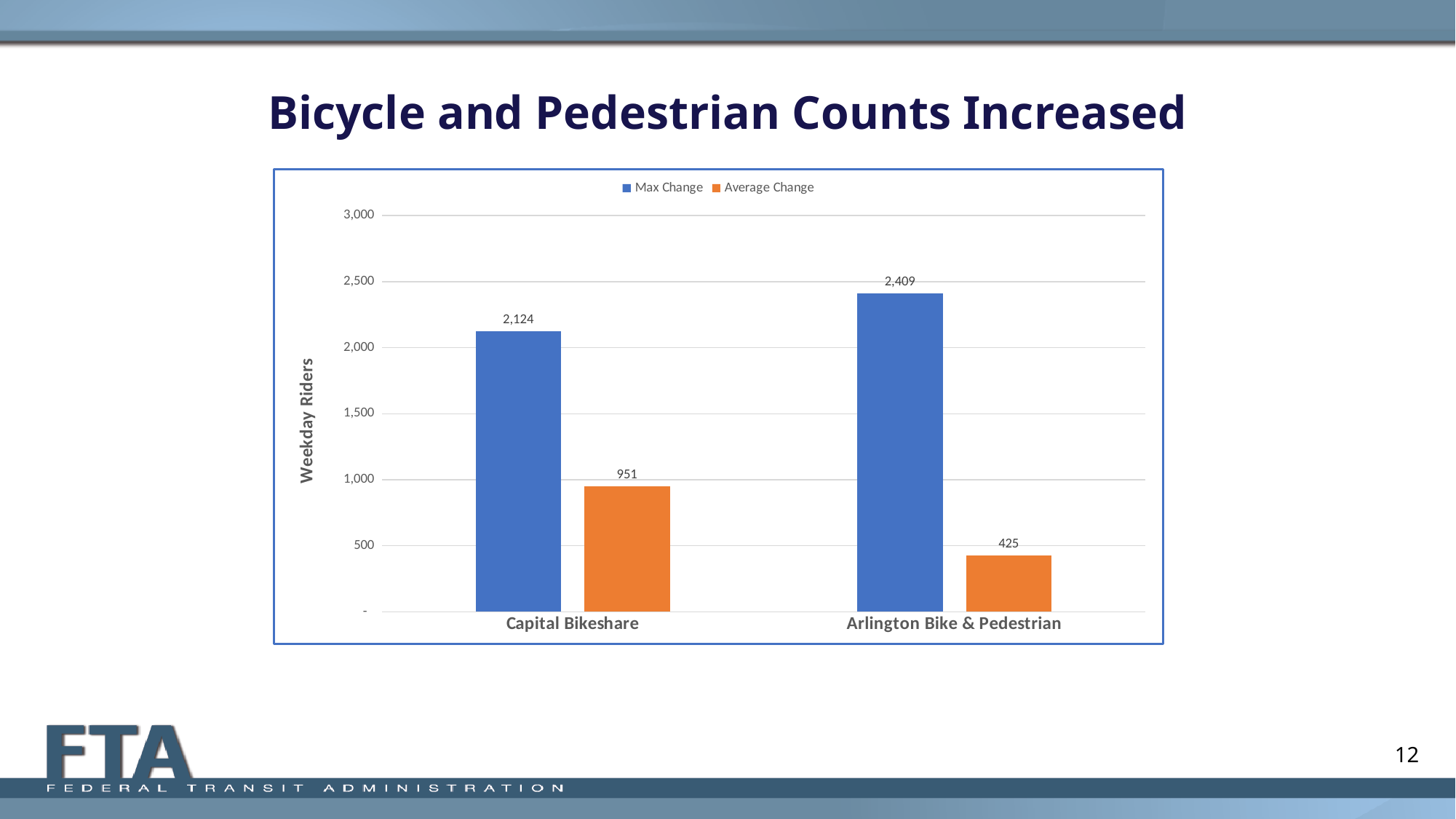
Which category has the lowest Average Change value? Arlington Bike & Pedestrian What is the difference between the Average Change values for Capital Bikeshare and Arlington Bike & Pedestrian? 526 How many series does the legend list? 2 What is the Average Change value for Arlington Bike & Pedestrian? 425 Is the Max Change value for Arlington Bike & Pedestrian greater or less than 2,500? less What kind of chart is shown on the slide? bar chart What is the Average Change value for Capital Bikeshare? 951 What is the difference between the Max Change values for Arlington Bike & Pedestrian and Capital Bikeshare? 285 Which is larger: the Average Change for Capital Bikeshare or the Average Change for Arlington Bike & Pedestrian? Capital Bikeshare What is the Max Change value for Capital Bikeshare? 2,124 Which category has the highest Max Change value? Arlington Bike & Pedestrian How many categories are shown on the x axis? 2